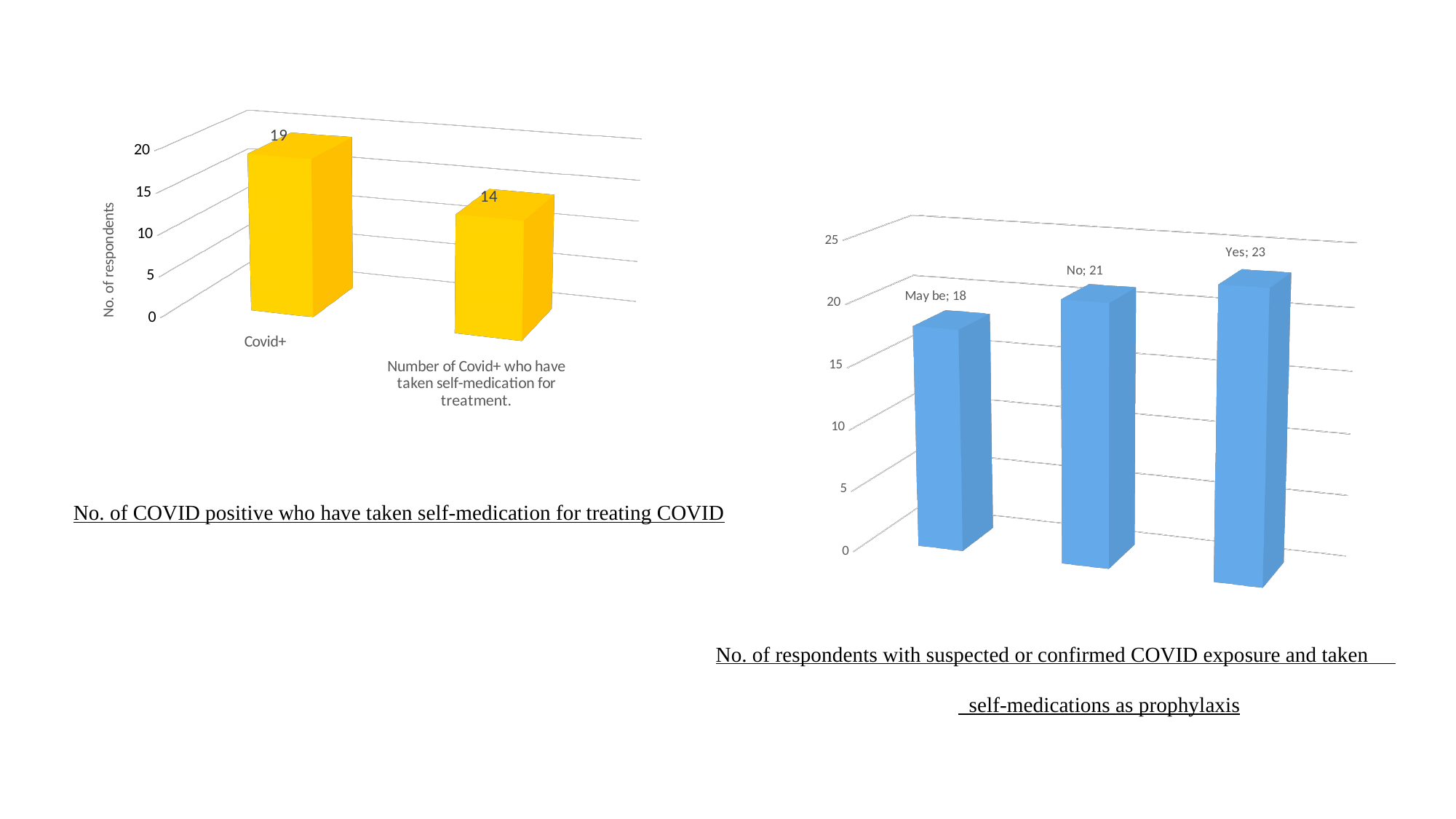
In the left chart, how many categories are plotted? 2 In the right chart, what is the value for May be? 18 In the left chart, what is the y-axis label? No. of respondents In the right chart, what is the difference between the Yes and No values? 2 In the left chart (No. of COVID positive who have taken self-medication for treating COVID), what is the value for Covid+? 19 In the right chart (No. of respondents with suspected or confirmed COVID exposure and taken self-medications as prophylaxis), what is the value for Yes? 23 In the right chart, is the value for No larger or smaller than the value for May be? larger In the left chart, what is the value for Number of Covid+ who have taken self-medication for treatment? 14 In the left chart, what is the difference between the Covid+ value and the number who have taken self-medication for treatment? 5 In the right chart, which category has the lowest value? May be In the left chart, which category has the higher value? Covid+ What kind of chart is the right chart? bar chart